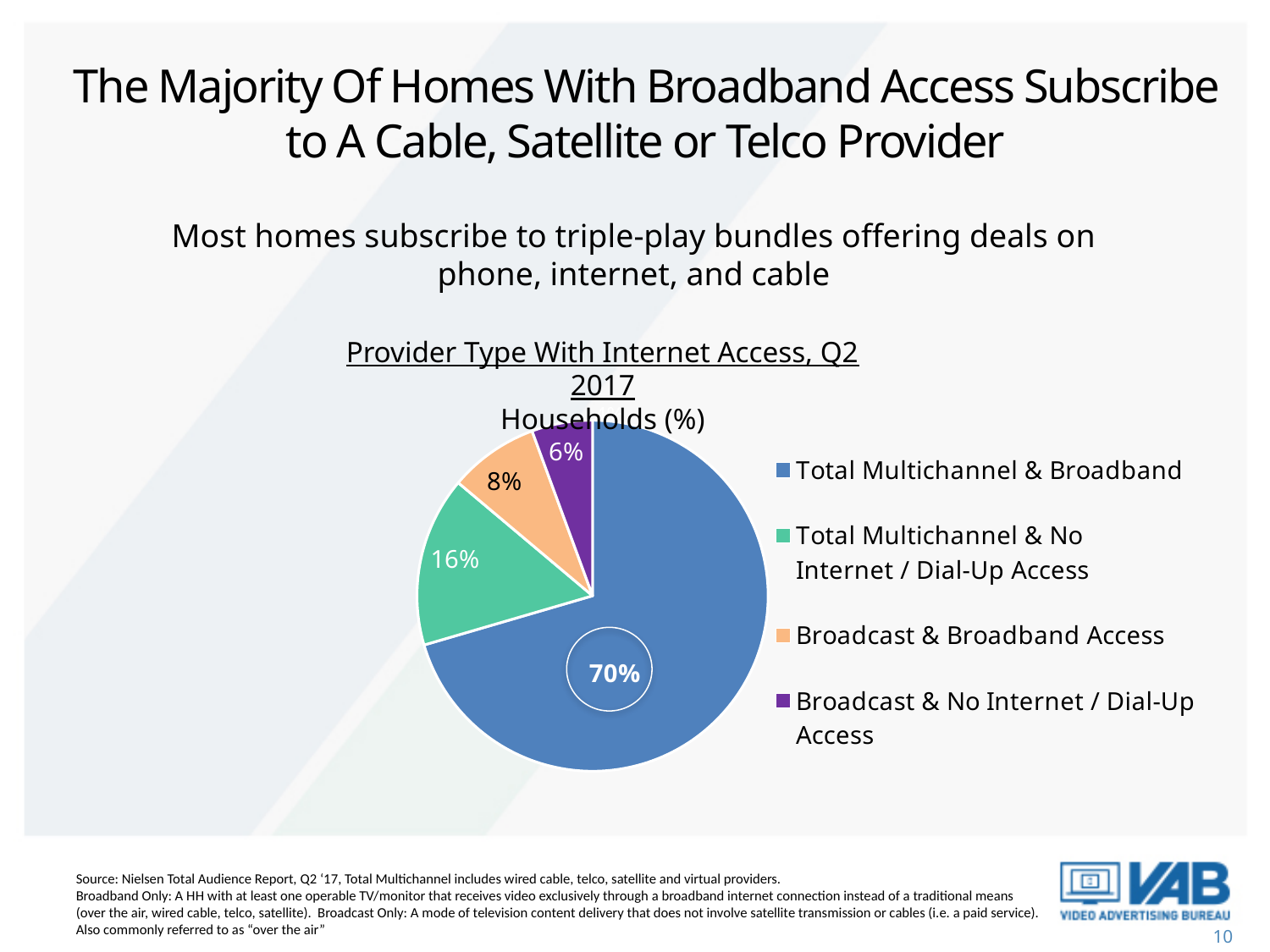
Which is larger: Broadcast & Broadband Access or Broadcast & No Internet / Dial-Up Access? Broadcast & Broadband Access What share of households is Total Multichannel & No Internet / Dial-Up Access? 16% Which category has the largest share of the pie? Total Multichannel & Broadband What type of chart is shown on the slide? pie chart What share of households is Broadcast & No Internet / Dial-Up Access? 6% Which category has the smallest share of the pie? Broadcast & No Internet / Dial-Up Access What share of households is Broadcast & Broadband Access? 8% What colour is the slice for Total Multichannel & No Internet / Dial-Up Access? green How many categories does the pie chart show? 4 What share of households is Total Multichannel & Broadband? 70% What is the title of the pie chart? Provider Type With Internet Access, Q2 2017 Households (%) What is the difference in percentage points between Total Multichannel & Broadband and Total Multichannel & No Internet / Dial-Up Access? 54